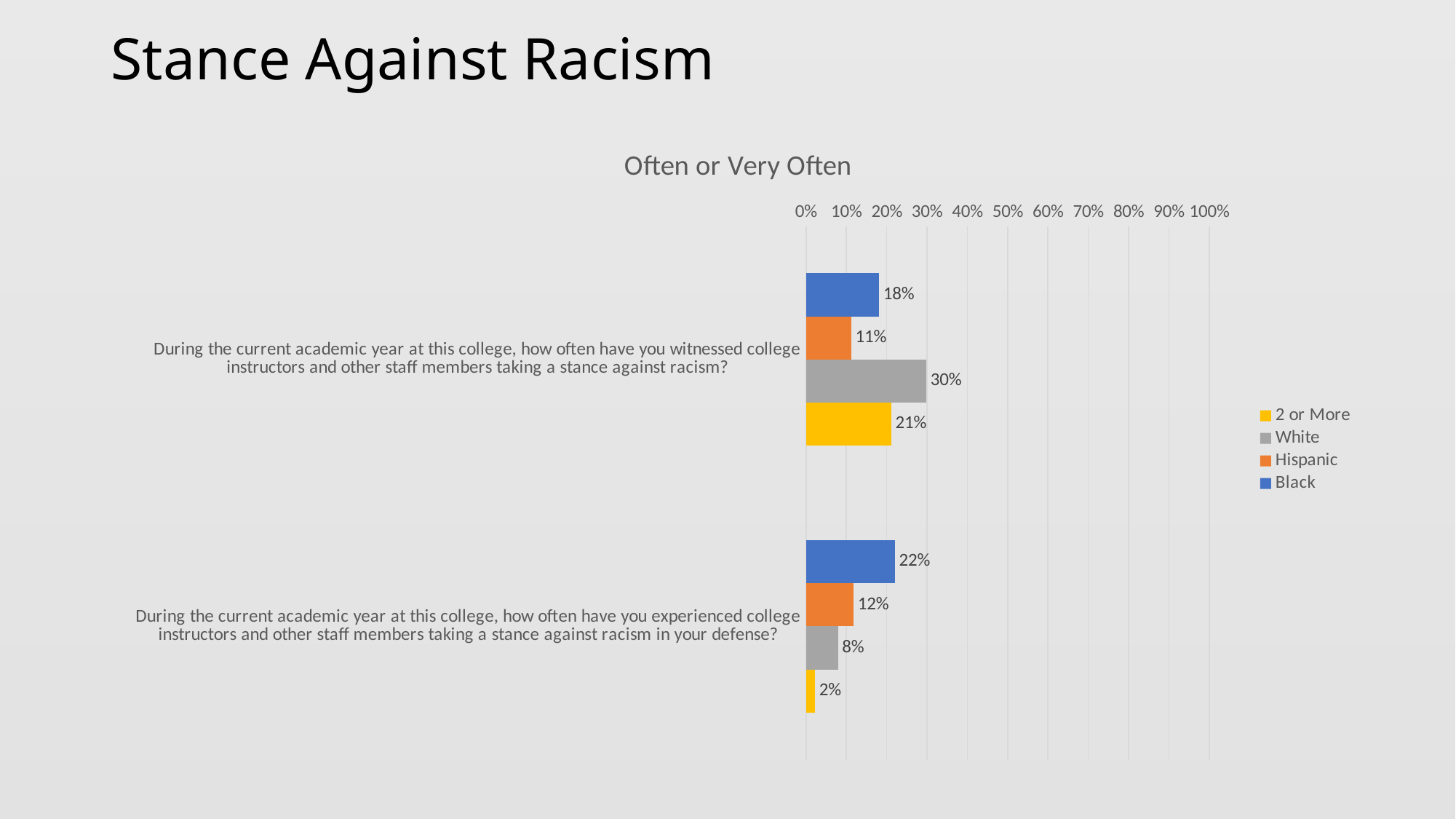
What is the value for White on the question about witnessing college instructors and staff taking a stance against racism? 30% What is the value for Black on the question about experiencing instructors and staff taking a stance against racism in your defense? 22% Is the value for White on the question about witnessing a stance against racism greater or less than 20%? greater Which is larger on the question about experiencing a stance against racism in your defense: the value for Black or the value for White? Black What is the value for 2 or More on the question about experiencing instructors and staff taking a stance against racism in your defense? 2% What is the difference between the White and Hispanic values on the question about witnessing instructors and staff taking a stance against racism? 19% What is the title of the chart? Often or Very Often Which group has the lowest value on the question about experiencing instructors and staff taking a stance against racism in your defense? 2 or More Which group has the highest value on the question about witnessing college instructors and staff taking a stance against racism? White What is the value for Hispanic on the question about witnessing college instructors and staff taking a stance against racism? 11% How many series does the legend list? 4 What kind of chart is shown on the slide? Bar chart